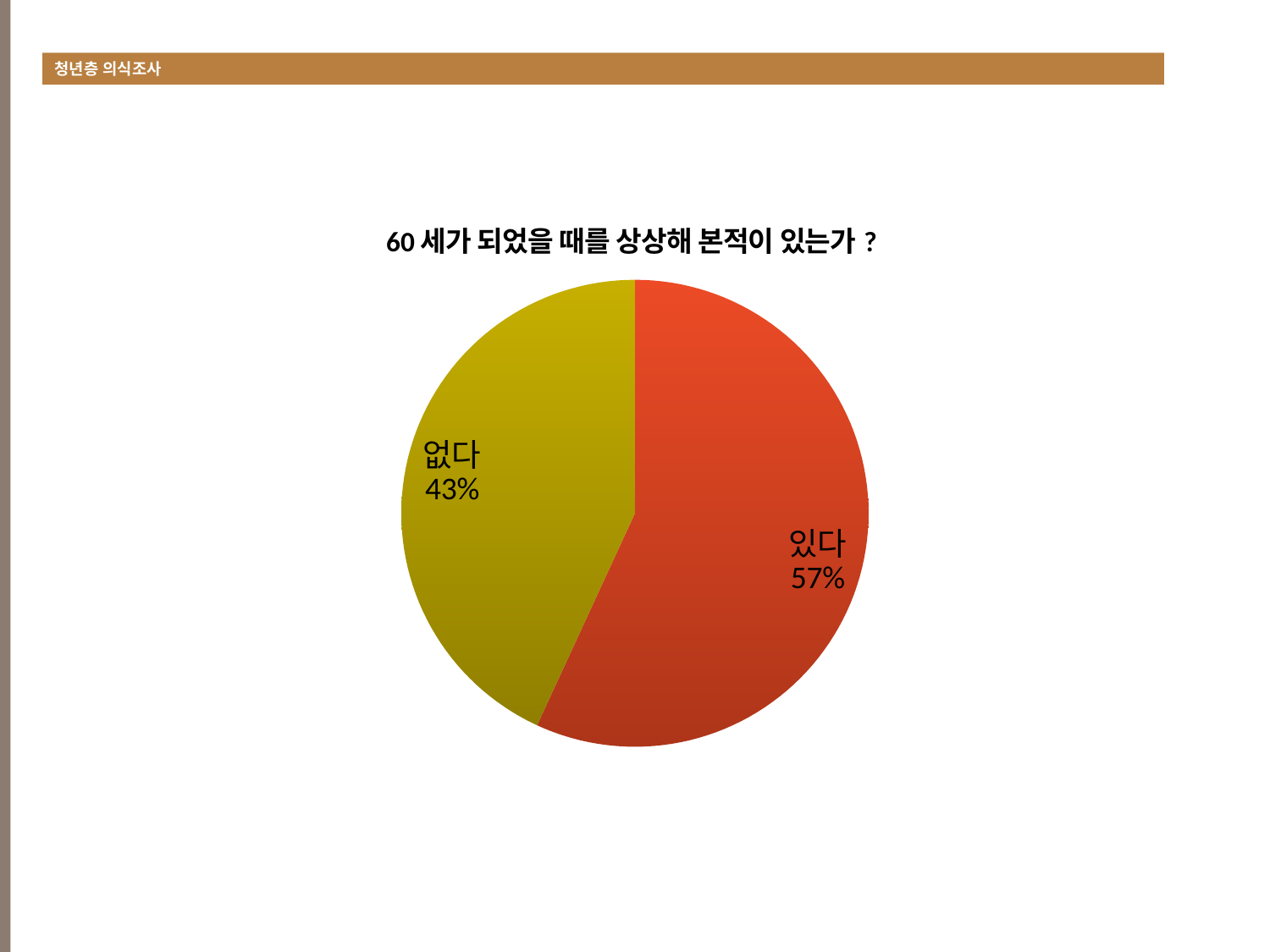
What kind of chart is shown on the slide? pie chart Which slice is the largest? 있다 What is the total of the two slices' percentages? 100% Which slice is the smallest? 없다 What is the difference in percentage points between the 있다 and 없다 slices? 14 What share of the pie does 없다 represent? 43% Which is larger, the 있다 slice or the 없다 slice? 있다 What colour is the 있다 slice? red-orange What percentage of the pie is the 있다 slice? 57% What percentage of the pie is the 없다 slice? 43% What is the title of the chart? 60 세가 되었을 때를 상상해 본적이 있는가 ? How many slices does the pie chart have? 2